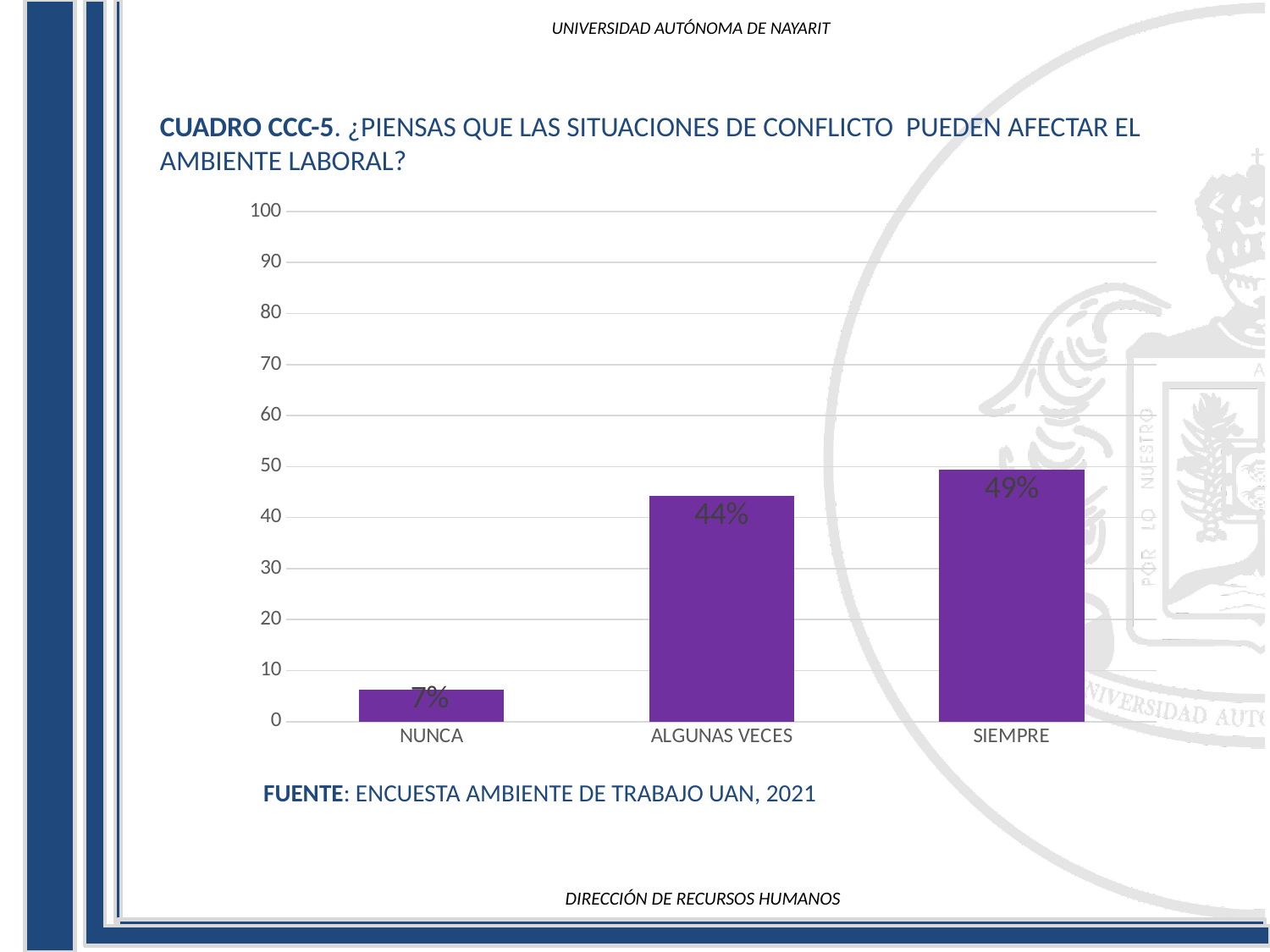
Which category has the lowest value? NUNCA What is the value for NUNCA? 7% What kind of chart is shown on the slide? bar chart What is the value for ALGUNAS VECES? 44% What is the difference between the values for ALGUNAS VECES and NUNCA? 37% Is the value for SIEMPRE greater or less than 40? greater Which category has the highest value? SIEMPRE What is the difference between the values for SIEMPRE and ALGUNAS VECES? 5% Which is larger, the value for NUNCA or the value for ALGUNAS VECES? ALGUNAS VECES What is the value for SIEMPRE? 49% How many categories are shown on the x axis? 3 What source is cited below the chart? ENCUESTA AMBIENTE DE TRABAJO UAN, 2021